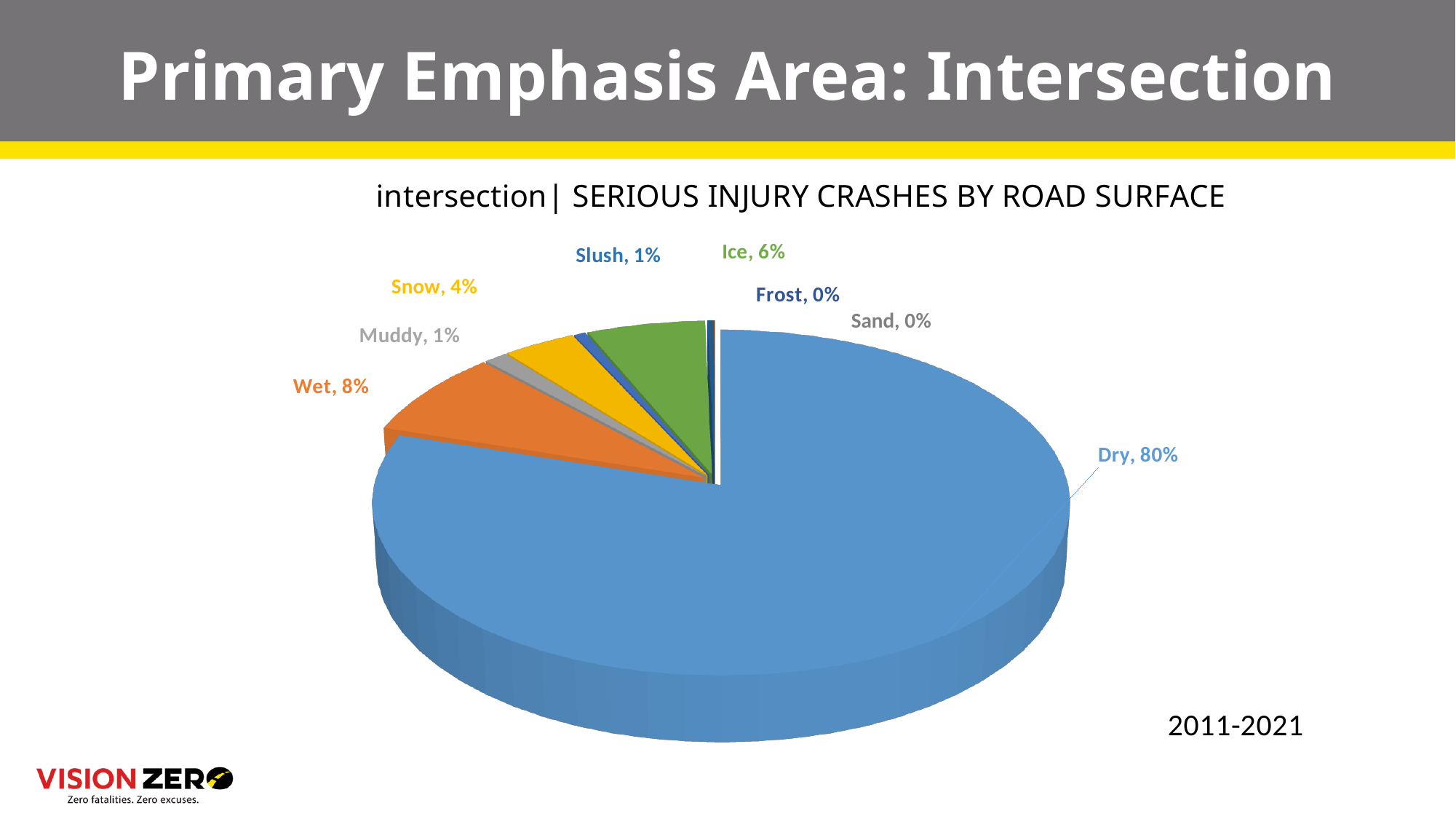
What time period does the chart cover, as shown on the slide? 2011-2021 What type of chart is shown on the slide? Pie chart Which has a larger share, Snow or Ice? Ice Which has a larger share, Wet or Snow? Wet What percentage of intersection serious injury crashes occurred on a wet road surface? 8% What is the share for Snow in the pie chart? 4% What is the difference in percentage points between the Wet and Ice shares? 2 What is the share for Ice in the pie chart? 6% Which road surface category has the largest share of serious injury crashes? Dry What is the difference in percentage points between the Dry and Wet shares? 72 What share of intersection serious injury crashes occurred on a dry road surface? 80% How many road surface categories are labelled on the pie chart? 8